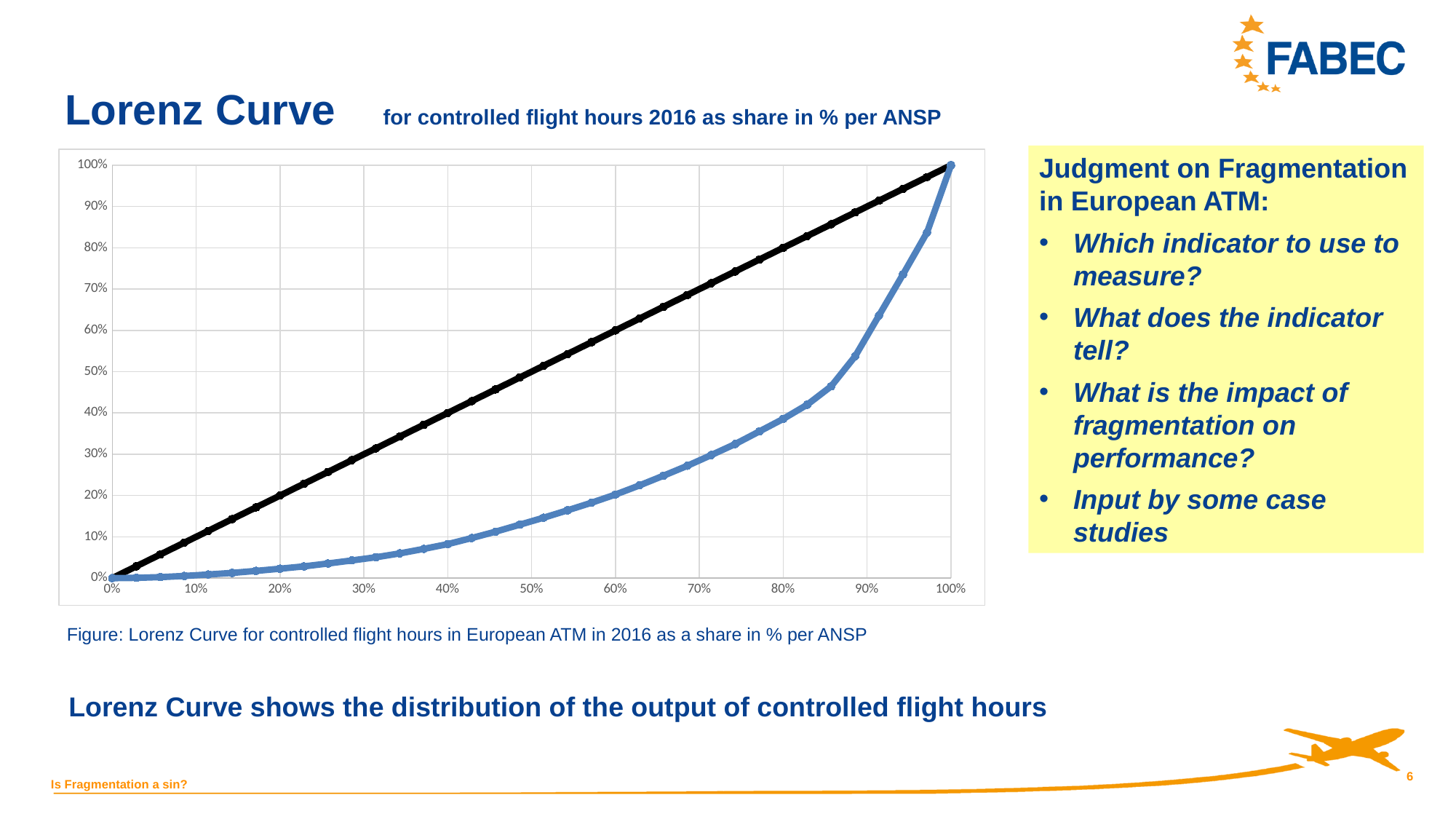
What is the value of the blue curve at 0% on the x axis? 0% What is the value of the blue curve at 100% on the x axis? 100% At 50% on the x axis, which line is higher, the black line or the blue curve? the black line How many lines are plotted on the chart? 2 Is the value of the blue curve at 90% on the x axis greater or less than 50%? greater Is the value of the blue curve at 60% on the x axis greater or less than 30%? less Is the value of the blue curve at 80% on the x axis greater or less than 50%? less What is the highest value shown on the y axis of the chart? 100% Does the blue curve rise or fall as the x axis increases? rise What kind of chart is shown on the slide? line chart